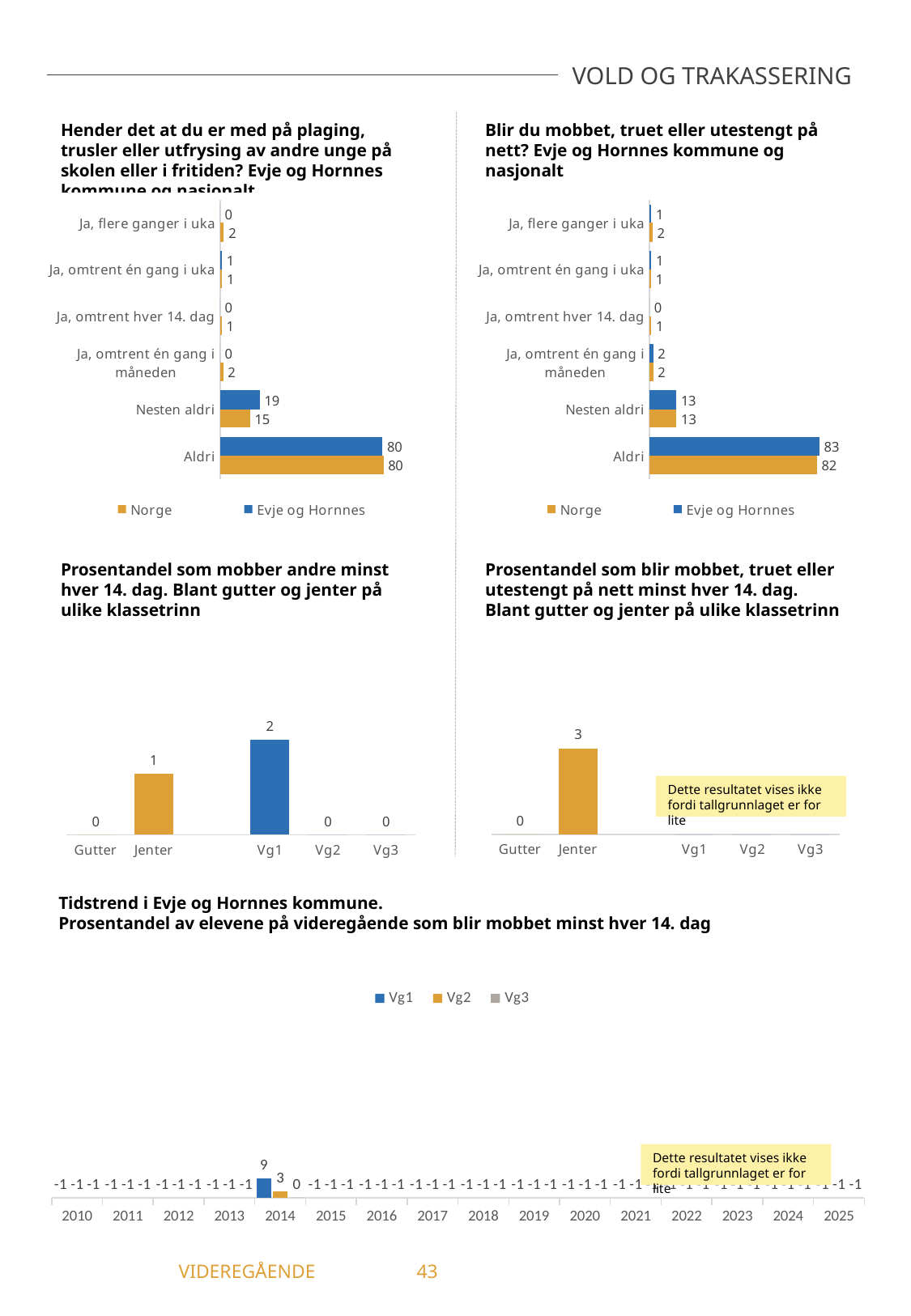
In the chart "Prosentandel som blir mobbet, truet eller utestengt på nett minst hver 14. dag", what is the value for Jenter? 3 In the bottom chart "Tidstrend i Evje og Hornnes kommune", what is the value for Vg1 in 2014? 9 How many categories are shown in the top-right chart ("Blir du mobbet, truet eller utestengt på nett?")? 6 In the top-left chart ("Hender det at du er med på plaging..."), what is the value for Norge in the category "Nesten aldri"? 15 In the top-right chart ("Blir du mobbet, truet eller utestengt på nett?"), which is larger for "Aldri": the Norge value or the Evje og Hornnes value? Evje og Hornnes In the chart "Prosentandel som mobber andre minst hver 14. dag", what is the value for Vg1? 2 What type of chart is the top-left chart ("Hender det at du er med på plaging...")? Bar chart In the top-right chart ("Blir du mobbet, truet eller utestengt på nett?"), which category has the highest values? Aldri In the top-right chart ("Blir du mobbet, truet eller utestengt på nett?"), what is the value for Evje og Hornnes in the category "Aldri"? 83 In the top-left chart ("Hender det at du er med på plaging..."), what is the difference between the Evje og Hornnes and Norge values for "Nesten aldri"? 4 How many series does the legend of the top-left chart ("Hender det at du er med på plaging...") list? 2 In the top-left chart ("Hender det at du er med på plaging..."), what is the value for Evje og Hornnes in the category "Nesten aldri"? 19